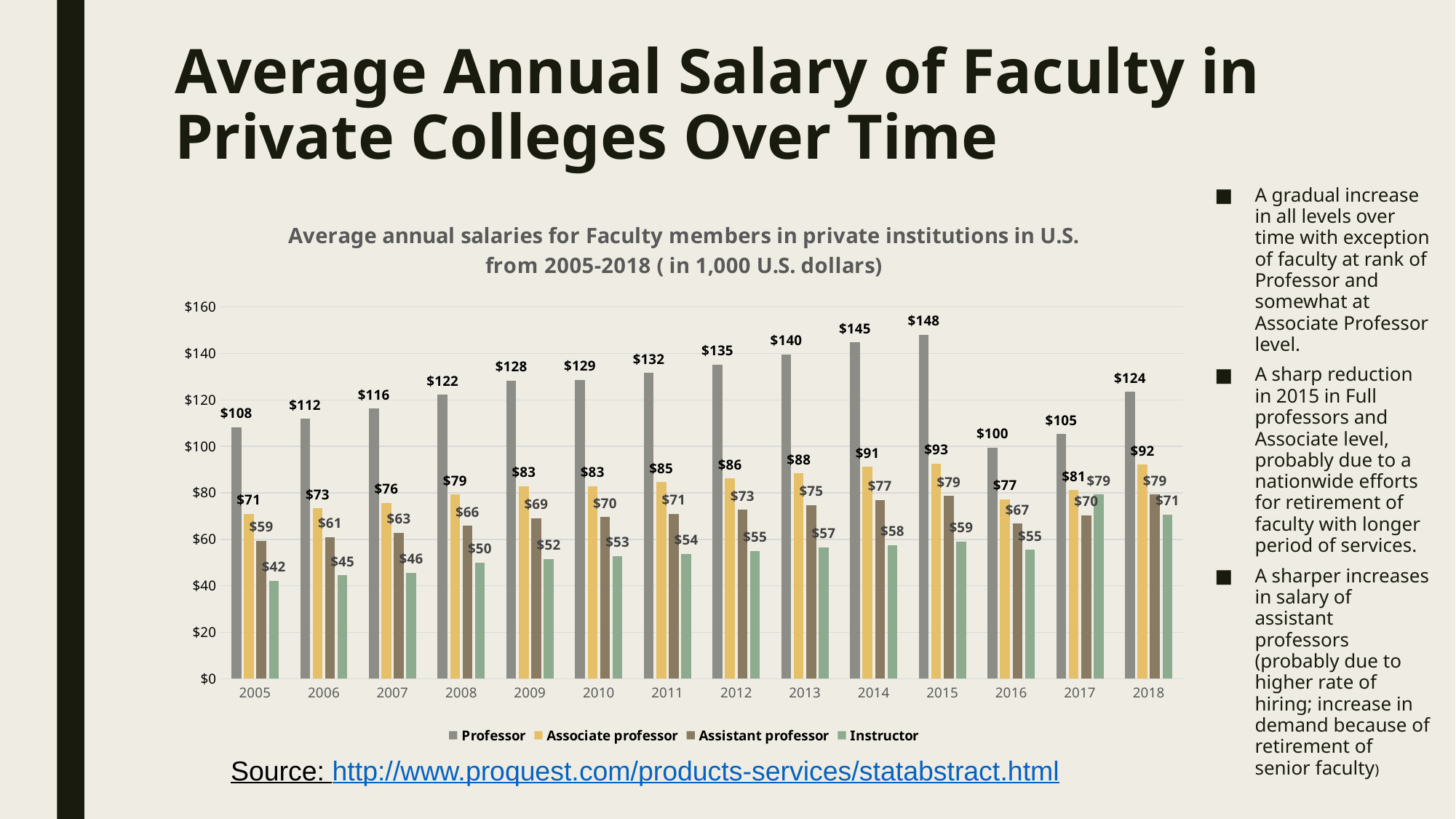
What is the difference between the Professor value in 2015 and the Professor value in 2016? $48 In which year is the Professor salary highest? 2015 What kind of chart is shown on the slide? Bar chart What is the value for Professor in 2015? $148 What is the difference between the Associate professor value and the Assistant professor value in 2014? $14 How many years are shown on the x axis? 14 How many series does the legend list? 4 What is the value for Instructor in 2005? $42 What is the value for Associate professor in 2018? $92 In which year is the Professor salary lowest? 2016 Do the Instructor values rise or fall from 2005 to 2018? Rise Which is larger in 2017: the Assistant professor value or the Instructor value? Instructor